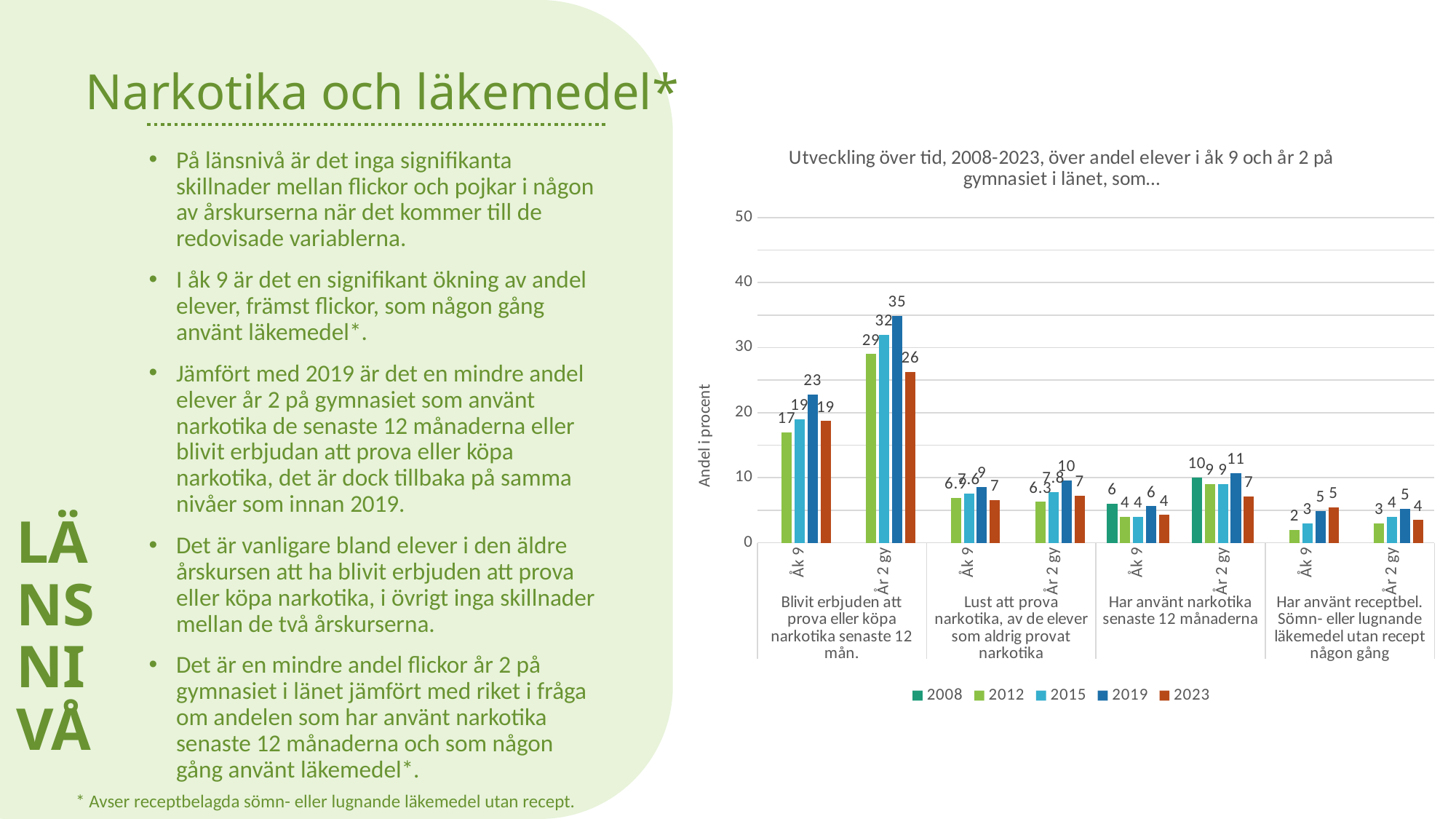
What is the label on the vertical axis of the chart? Andel i procent For År 2 gy under "Har använt narkotika senaste 12 månaderna", which year has the lowest value? 2023 What is the 2023 value for Åk 9 under "Blivit erbjuden att prova eller köpa narkotika senaste 12 mån."? 19 For År 2 gy under "Blivit erbjuden att prova eller köpa narkotika senaste 12 mån.", which year has the highest value? 2019 Is the 2012 value for År 2 gy under "Blivit erbjuden att prova eller köpa narkotika senaste 12 mån." greater or less than 20? greater What is the 2019 value for År 2 gy under "Blivit erbjuden att prova eller köpa narkotika senaste 12 mån."? 35 What is the 2019 value for År 2 gy under "Har använt narkotika senaste 12 månaderna"? 11 How many series does the legend list? 5 For År 2 gy under "Blivit erbjuden att prova eller köpa narkotika senaste 12 mån.", what is the difference between the 2019 and 2023 values? 9 For Åk 9 under "Har använt narkotika senaste 12 månaderna", which is larger: the 2008 value or the 2012 value? 2008 What is the 2012 value for Åk 9 under "Har använt receptbel. Sömn- eller lugnande läkemedel utan recept någon gång"? 2 What kind of chart is shown on the slide? Bar chart